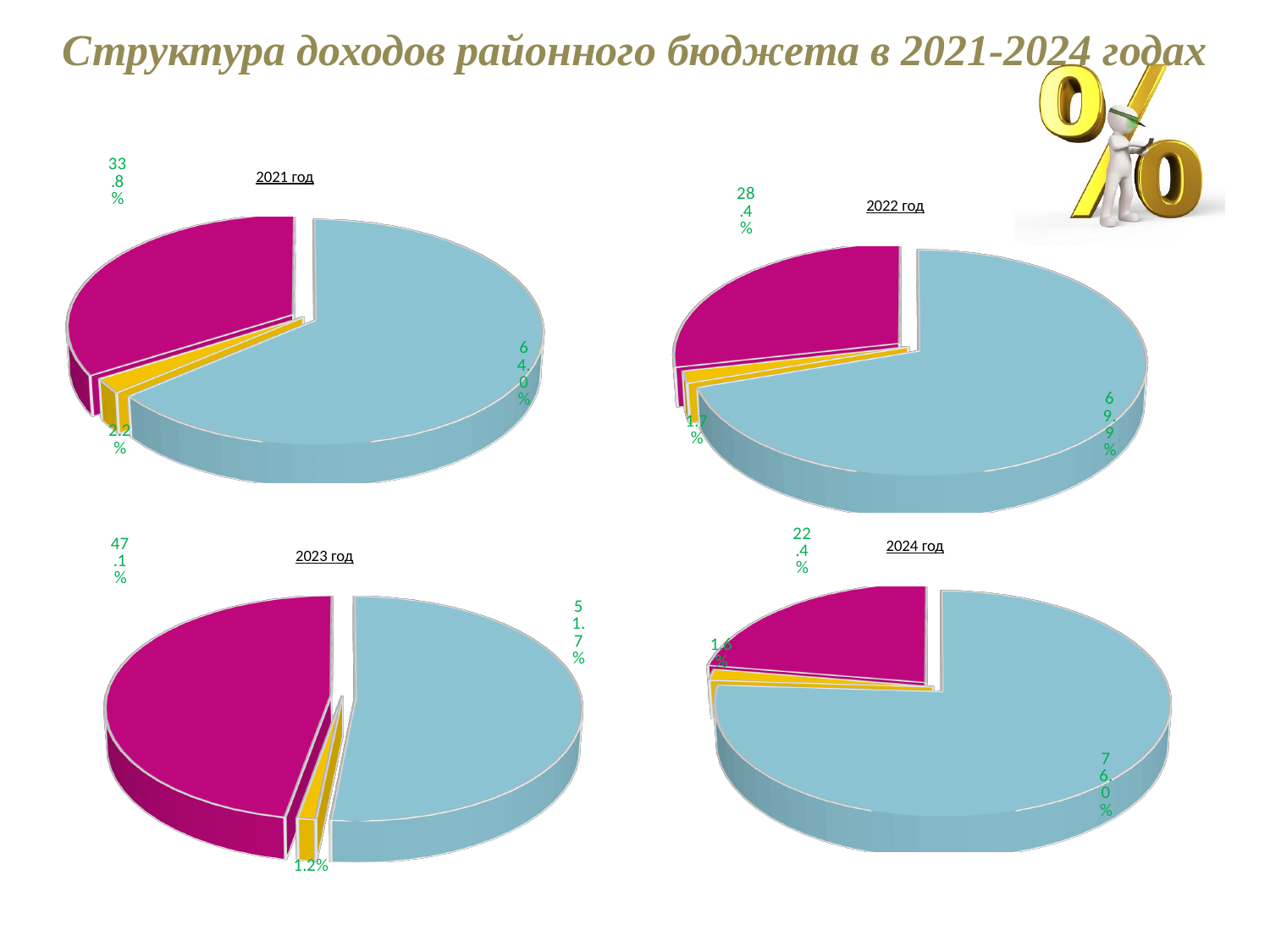
In the 2024 год pie chart, what share does the light blue slice have? 76.0% In the 2023 год pie chart, what share does the magenta slice have? 47.1% In the 2021 год pie chart, what share does the magenta slice have? 33.8% In the 2024 год pie chart, which slice is the smallest? the yellow slice (1.6%) How many slices does each pie chart on the slide have? 3 In the 2023 год pie chart, what is the difference between the light blue slice and the magenta slice? 4.6% What kind of chart is used for the 2021 год data? pie chart How many pie charts are shown on the slide? 4 Which is larger in the 2022 год pie chart: the magenta slice or the light blue slice? the light blue slice